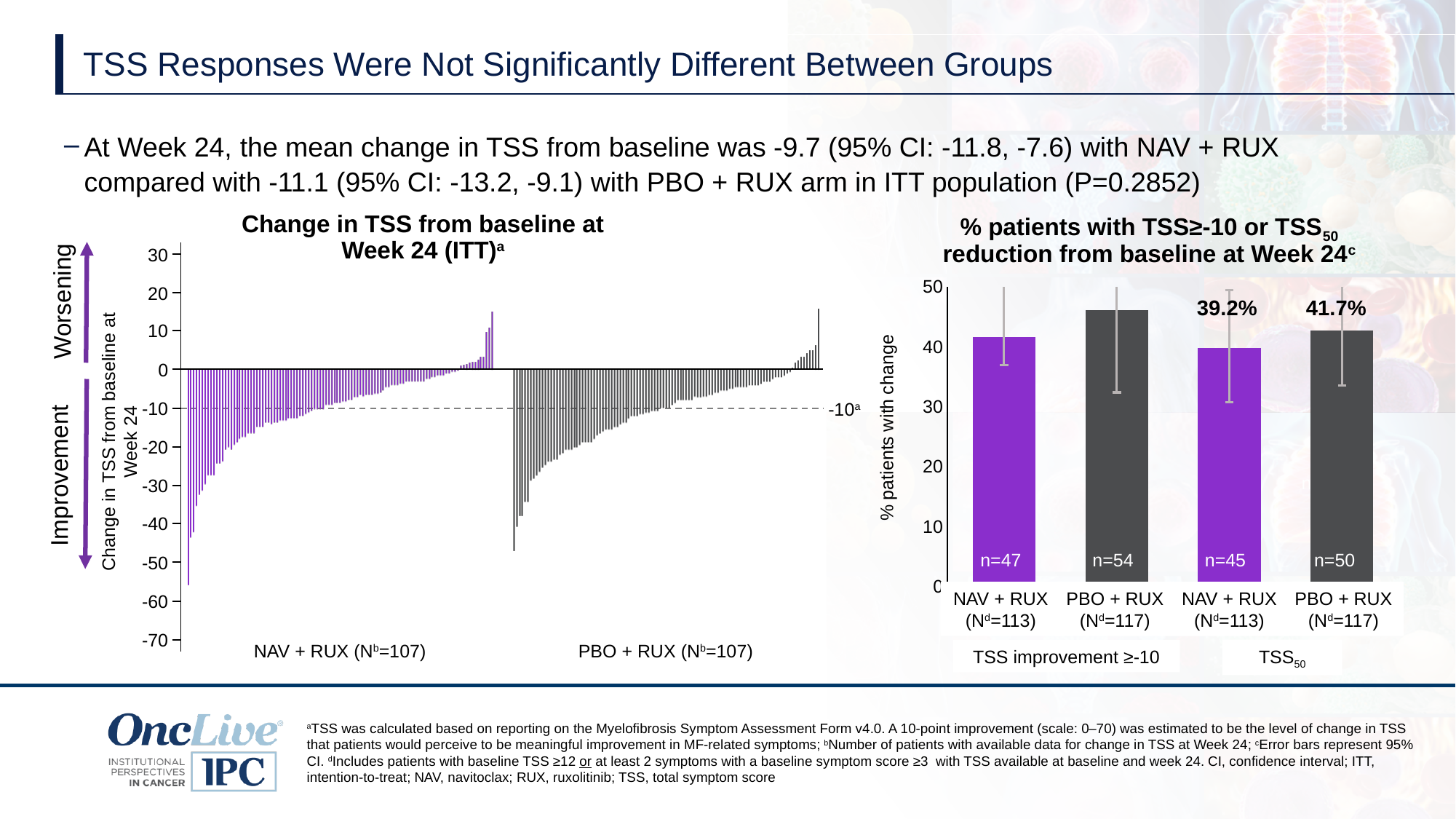
In the right-hand chart, which arm has the higher TSS50 percentage, NAV + RUX or PBO + RUX? PBO + RUX In the right-hand chart, what percentage of patients achieved TSS50 in the PBO + RUX arm? 41.7% In the left-hand chart, what is the N value given for the NAV + RUX group? 107 In the right-hand chart, what is the difference between the TSS50 percentages for PBO + RUX and NAV + RUX? 2.5% In the right-hand chart, what is the n value shown inside the NAV + RUX bar for TSS improvement ≥-10? n=47 In the right-hand chart, which bar is the tallest? PBO + RUX, TSS improvement ≥-10 What kind of chart is the right-hand chart titled '% patients with TSS≥-10 or TSS50 reduction from baseline at Week 24'? Bar chart In the right-hand chart, what percentage of patients achieved TSS50 in the NAV + RUX arm? 39.2% How many bars are plotted in the right-hand chart? 4 In the right-hand chart, is the value for PBO + RUX in the 'TSS improvement ≥-10' group greater or less than 40? greater In the left-hand chart 'Change in TSS from baseline at Week 24 (ITT)', what value does the horizontal dashed line mark? -10 In the right-hand chart, what is the n value shown inside the PBO + RUX bar for TSS improvement ≥-10? n=54